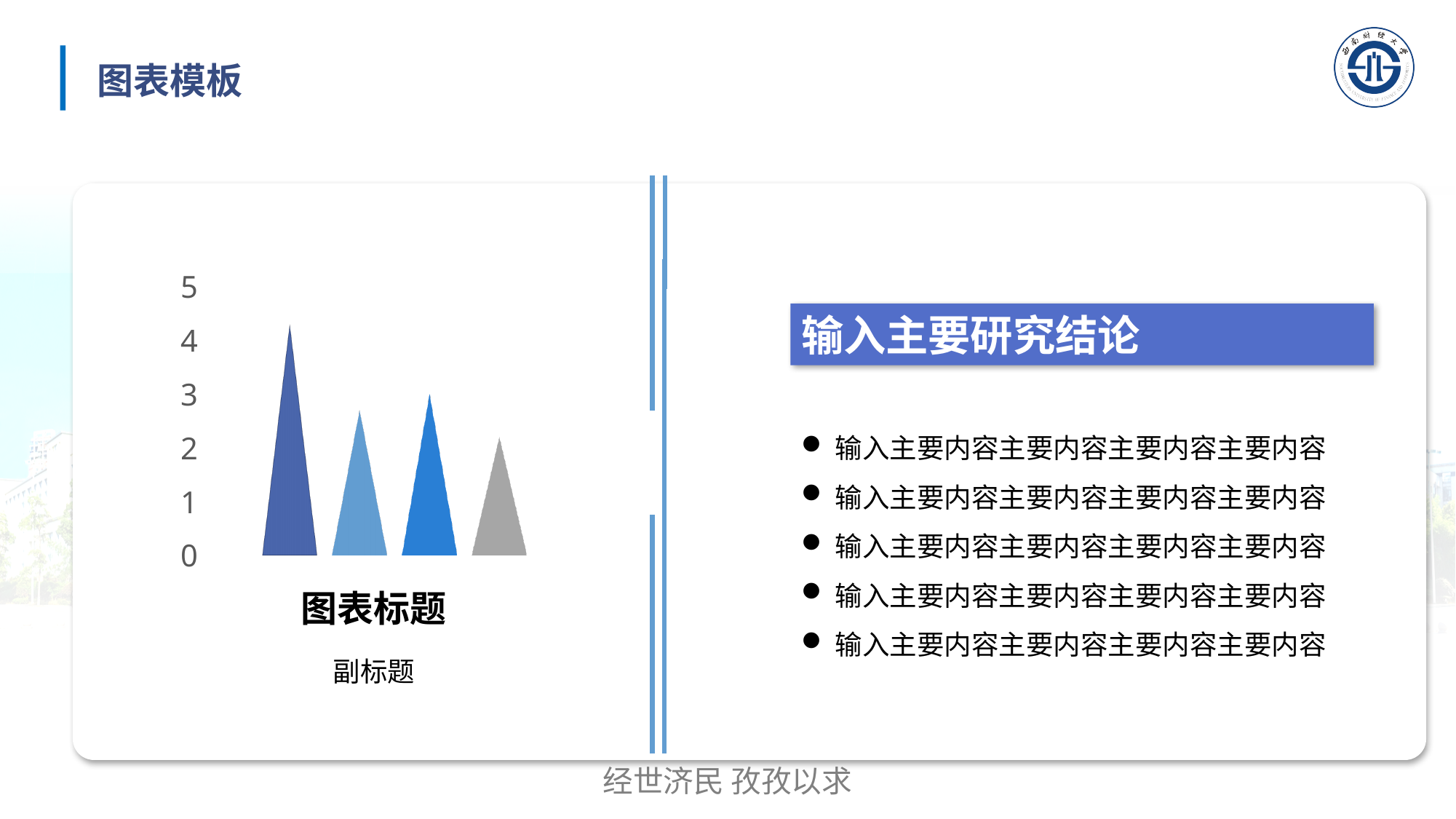
Which bar is the shortest in the chart? the fourth bar from the left Is the value of the first bar from the left greater or less than 3? greater How many bars are plotted in the chart? 4 Is the value of the fourth bar from the left greater or less than 3? less What is the title of the chart? 图表标题 Is the value of the third bar from the left greater or less than 2? greater What is the subtitle shown below the chart title? 副标题 What kind of chart is shown on the slide? bar chart Which bar is the tallest in the chart? the first bar from the left Which is larger, the second bar or the fourth bar from the left? the second bar Which is larger, the first bar or the third bar from the left? the first bar